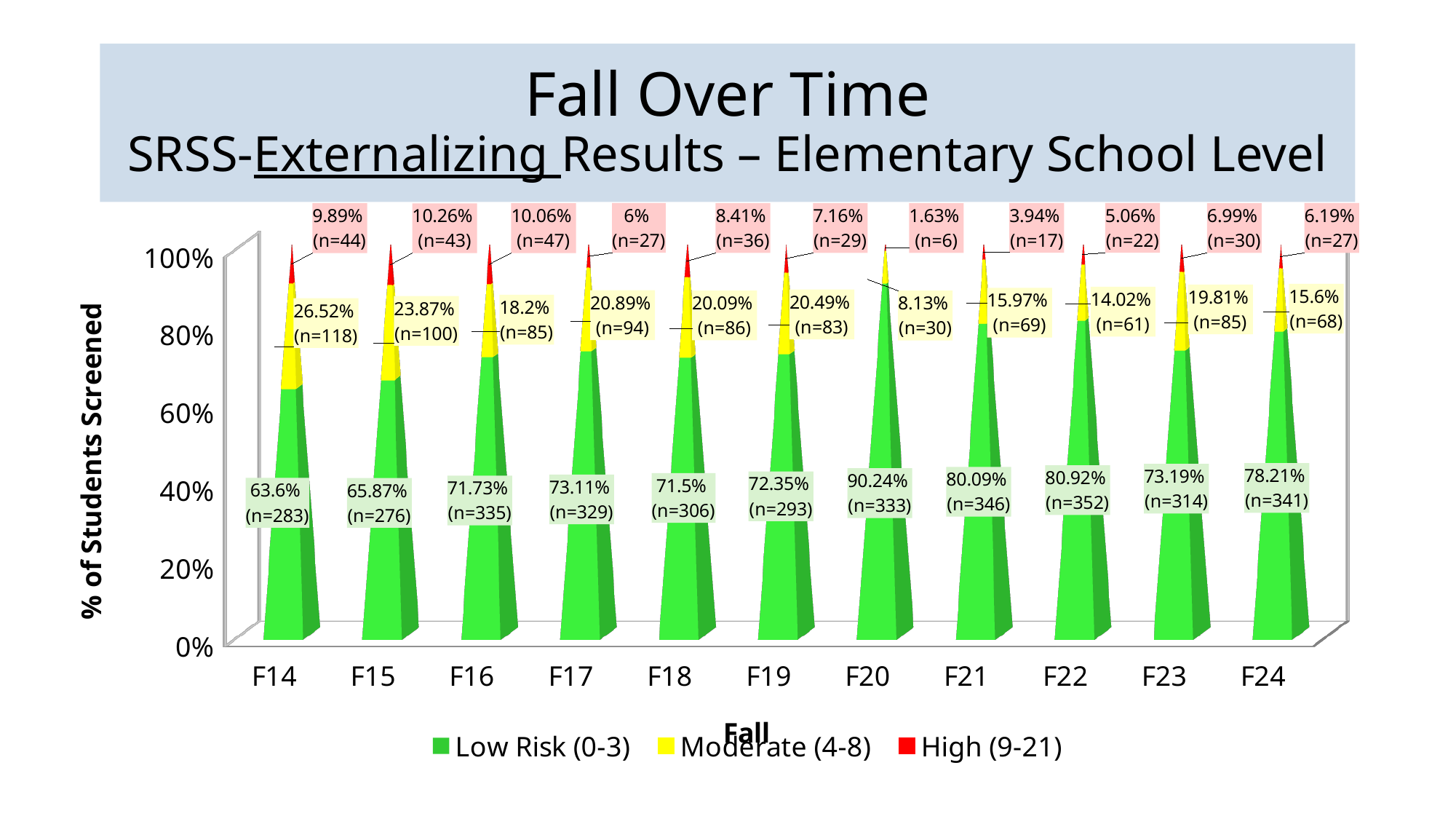
How many students were in the Low Risk (0-3) group in F22? n=352 Which fall has the highest Moderate (4-8) percentage? F14 What is the Low Risk (0-3) percentage for F20? 90.24% Which is larger, the High (9-21) percentage for F16 or for F17? F16 What is the Moderate (4-8) percentage for F23? 19.81% What kind of chart is shown on the slide? Stacked bar chart How many fall periods are shown on the x axis? 11 Which fall has the lowest High (9-21) percentage? F20 Which fall has the highest Low Risk (0-3) percentage? F20 How many series does the legend list? 3 What is the High (9-21) percentage for F15? 10.26% What is the difference between the Low Risk (0-3) percentages for F22 and F21? 0.83%